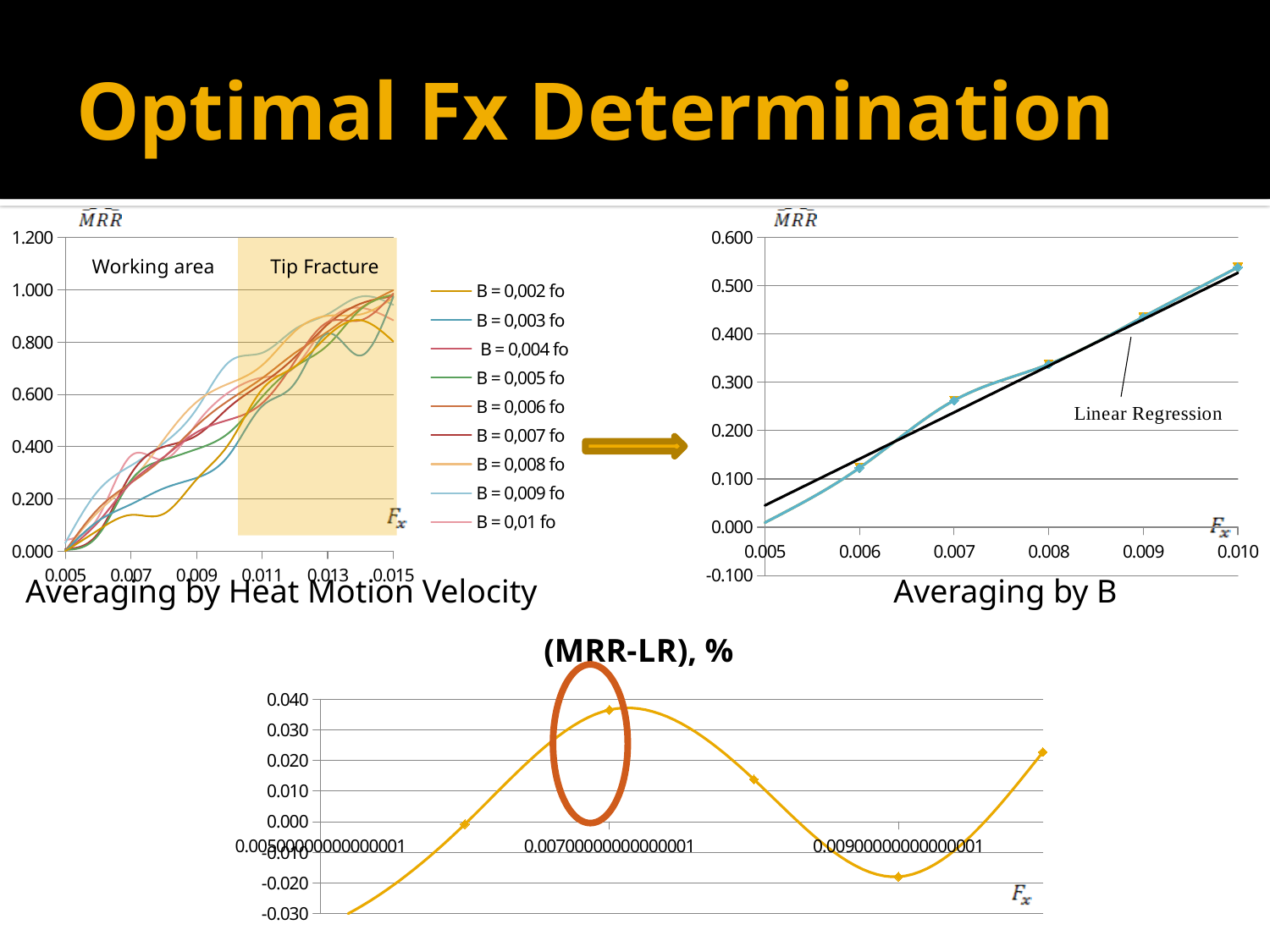
In the bottom chart '(MRR-LR), %', at which Fx value is the plotted value highest? 0.007 What kind of chart is the top-left chart titled 'Averaging by Heat Motion Velocity'? line chart In the 'Averaging by Heat Motion Velocity' chart, what is the label of the shaded region on the right? Tip Fracture In the bottom chart '(MRR-LR), %', at which Fx value is the plotted value lowest? 0.005 What is the label of the straight black line in the 'Averaging by B' chart? Linear Regression How many series does the legend of the 'Averaging by Heat Motion Velocity' chart list? 9 In the 'Averaging by B' chart, do the plotted values rise or fall as Fx increases from 0.005 to 0.010? rise In the bottom chart '(MRR-LR), %', is the value at Fx = 0.009 greater or less than -0.010? less In the 'Averaging by B' chart, is the value at Fx = 0.010 greater or less than 0.500? greater In the bottom chart '(MRR-LR), %', which is larger: the value at Fx = 0.007 or the value at Fx = 0.008? 0.007 In the 'Averaging by B' chart, is the value at Fx = 0.009 greater or less than 0.400? greater